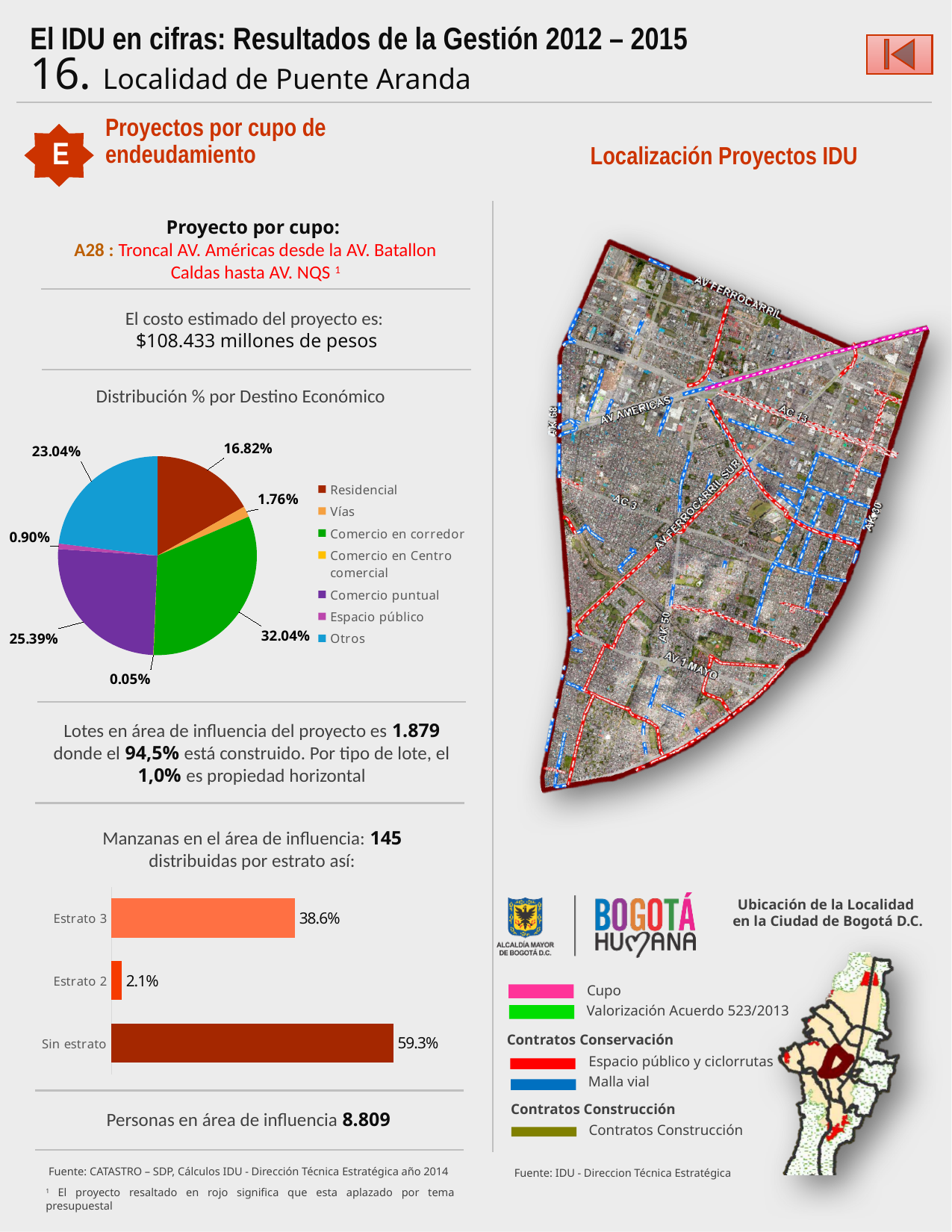
In the bar chart 'Manzanas en el área de influencia', which category has the highest value? Sin estrato In the pie chart 'Distribución % por Destino Económico', how many categories does the legend list? 7 In the pie chart 'Distribución % por Destino Económico', what percentage is Residencial? 16.82% What type of chart is used for 'Distribución % por Destino Económico'? Pie chart In the bar chart 'Manzanas en el área de influencia', what is the value for Estrato 3? 38.6% In the pie chart 'Distribución % por Destino Económico', which is larger, Vías or Espacio público? Vías In the pie chart 'Distribución % por Destino Económico', what is the difference between Comercio puntual and Otros? 2.35% What type of chart is used for 'Manzanas en el área de influencia'? Bar chart In the pie chart 'Distribución % por Destino Económico', which category has the smallest share? Comercio en Centro comercial In the pie chart 'Distribución % por Destino Económico', which category has the largest share? Comercio en corredor In the pie chart 'Distribución % por Destino Económico', what percentage is Comercio en corredor? 32.04% In the bar chart 'Manzanas en el área de influencia', what is the difference between Sin estrato and Estrato 2? 57.2%